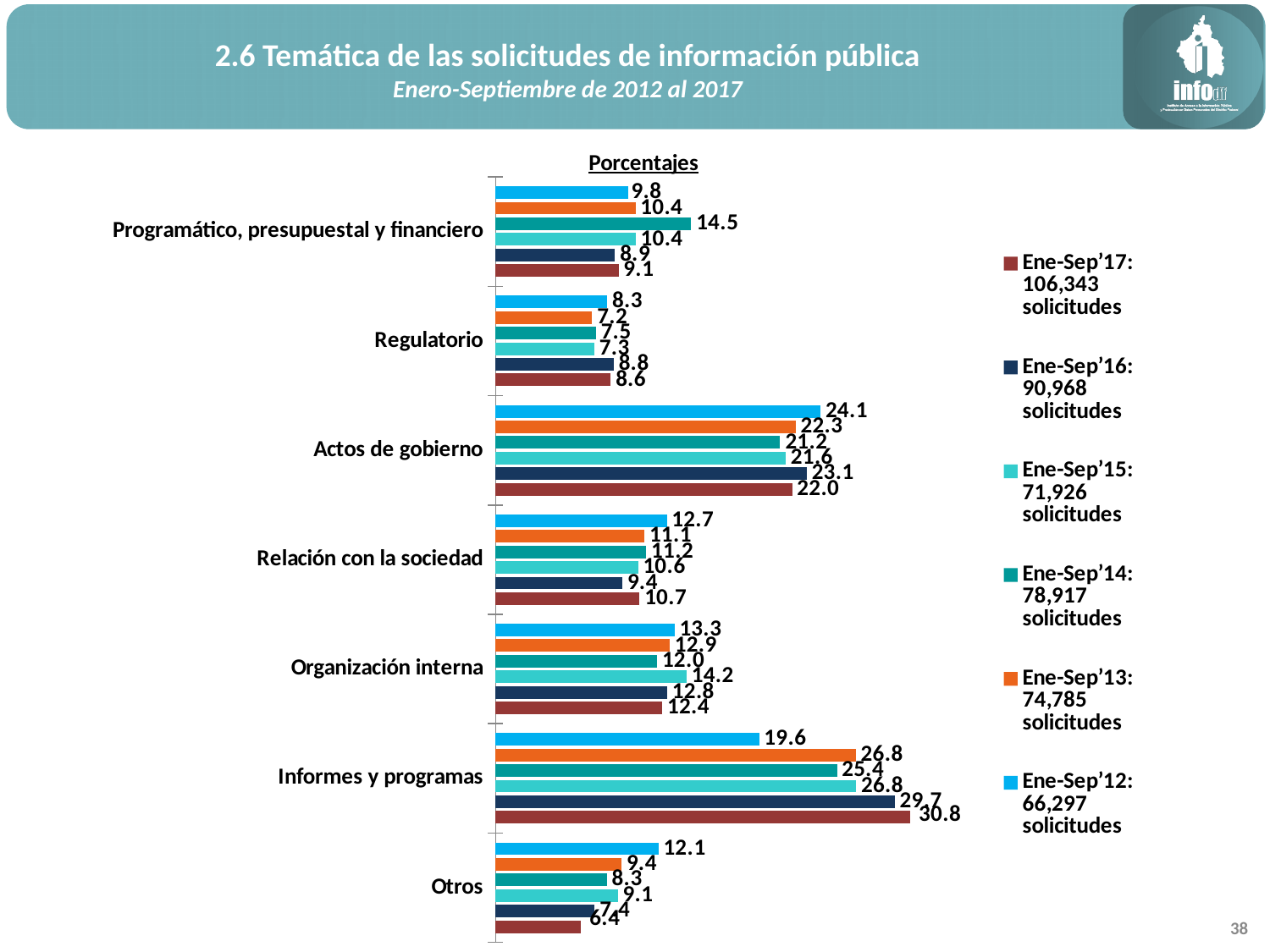
How many categories (temáticas) are shown on the chart? 7 How many series does the legend list? 6 Which category has the highest percentage in Ene-Sep'17? Informes y programas Which is larger for Otros: the Ene-Sep'12 value or the Ene-Sep'17 value? Ene-Sep'12 What is the percentage for Actos de gobierno in Ene-Sep'12? 24.1 Which category has the lowest percentage in Ene-Sep'17? Otros What is the difference between the Ene-Sep'17 and Ene-Sep'12 percentages for Informes y programas? 11.2 What is the percentage for Regulatorio in Ene-Sep'16? 8.8 What kind of chart is shown on the slide? Bar chart What is the percentage for Programático, presupuestal y financiero in Ene-Sep'14? 14.5 What is the percentage for Informes y programas in Ene-Sep'17? 30.8 How many solicitudes does the legend report for Ene-Sep'17? 106,343